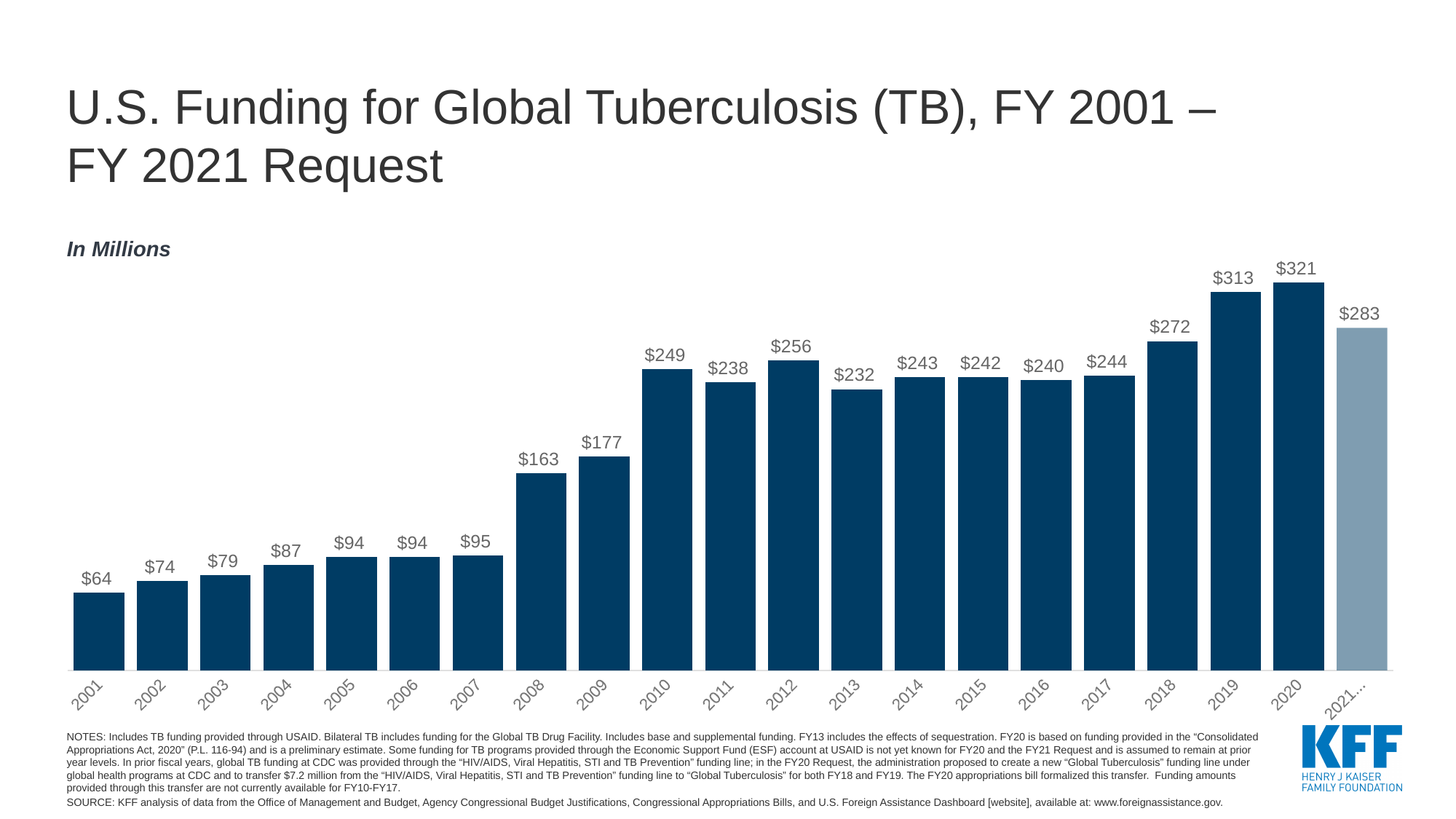
What is the value for 2012? $256 Which year has the highest value? 2020 How many bars are shown in the chart? 21 Which is larger, the value for 2013 or the value for 2017? 2017 What is the value for the 2021 Request bar? $283 What kind of chart is shown on the slide? Bar chart What is the value for 2001? $64 Do the values generally rise or fall from 2001 to 2020? Rise What is the difference between the values for 2010 and 2009? $72 What is the difference between the values for 2020 and 2019? $8 What unit is stated for the values in the chart? In Millions Which year has the lowest value? 2001